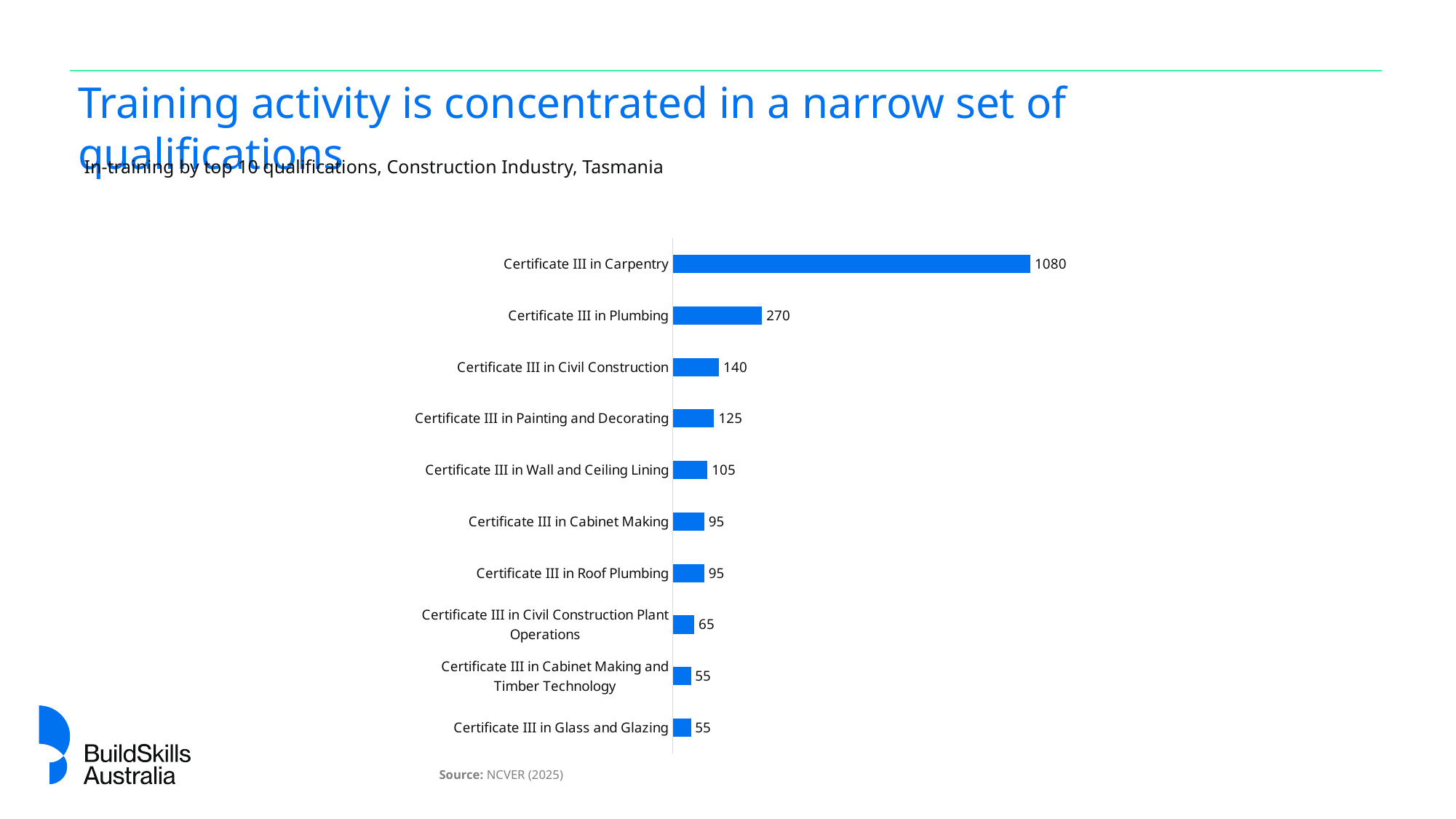
What kind of chart is shown on the slide? Bar chart Which qualification has the highest value? Certificate III in Carpentry What is the source cited for the chart? NCVER (2025) What is the difference between the values for Certificate III in Civil Construction and Certificate III in Painting and Decorating? 15 What is the subtitle of the chart? In-training by top 10 qualifications, Construction Industry, Tasmania What is the difference between the values for Certificate III in Carpentry and Certificate III in Plumbing? 810 What is the value for Certificate III in Plumbing? 270 What is the value for Certificate III in Civil Construction Plant Operations? 65 How many qualifications are shown in the chart? 10 What is the value for Certificate III in Wall and Ceiling Lining? 105 Which is larger, the value for Certificate III in Plumbing or the value for Certificate III in Civil Construction? Certificate III in Plumbing What is the value for Certificate III in Carpentry? 1080